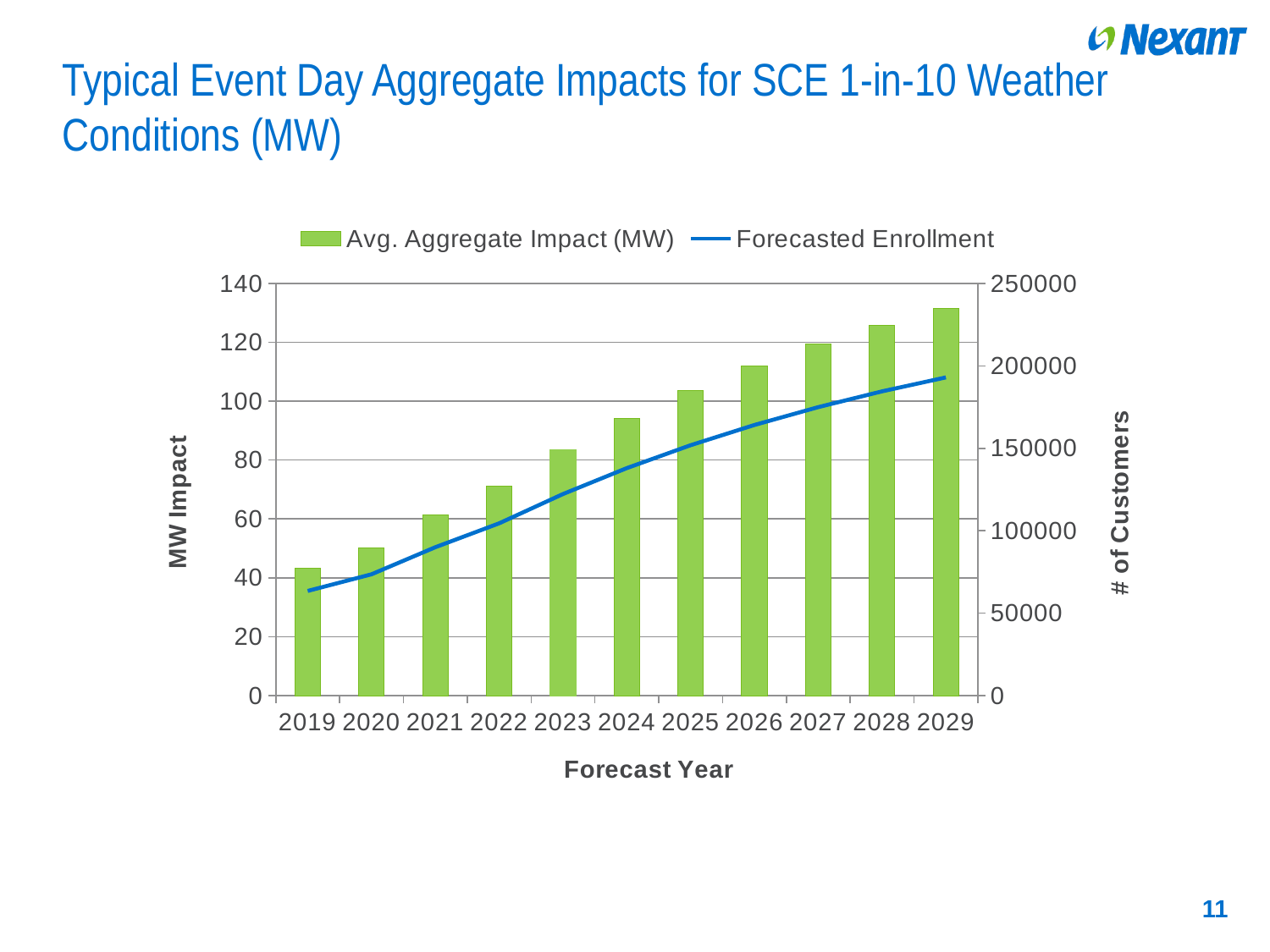
Which forecast year has the highest Avg. Aggregate Impact (MW)? 2029 Is the Avg. Aggregate Impact (MW) for 2022 greater or less than 80? less Is the Avg. Aggregate Impact (MW) for 2024 greater or less than 80? greater How many forecast years are shown on the x axis? 11 Do the Avg. Aggregate Impact (MW) bars rise or fall from 2019 to 2029? Rise What is the label of the right-hand vertical axis? # of Customers How many series does the legend list? 2 What kind of chart is shown on the slide? A combination bar and line chart Which year has a larger Avg. Aggregate Impact (MW), 2021 or 2026? 2026 Which forecast year has the lowest Avg. Aggregate Impact (MW)? 2019 Is the Avg. Aggregate Impact (MW) for 2029 greater or less than 120? greater